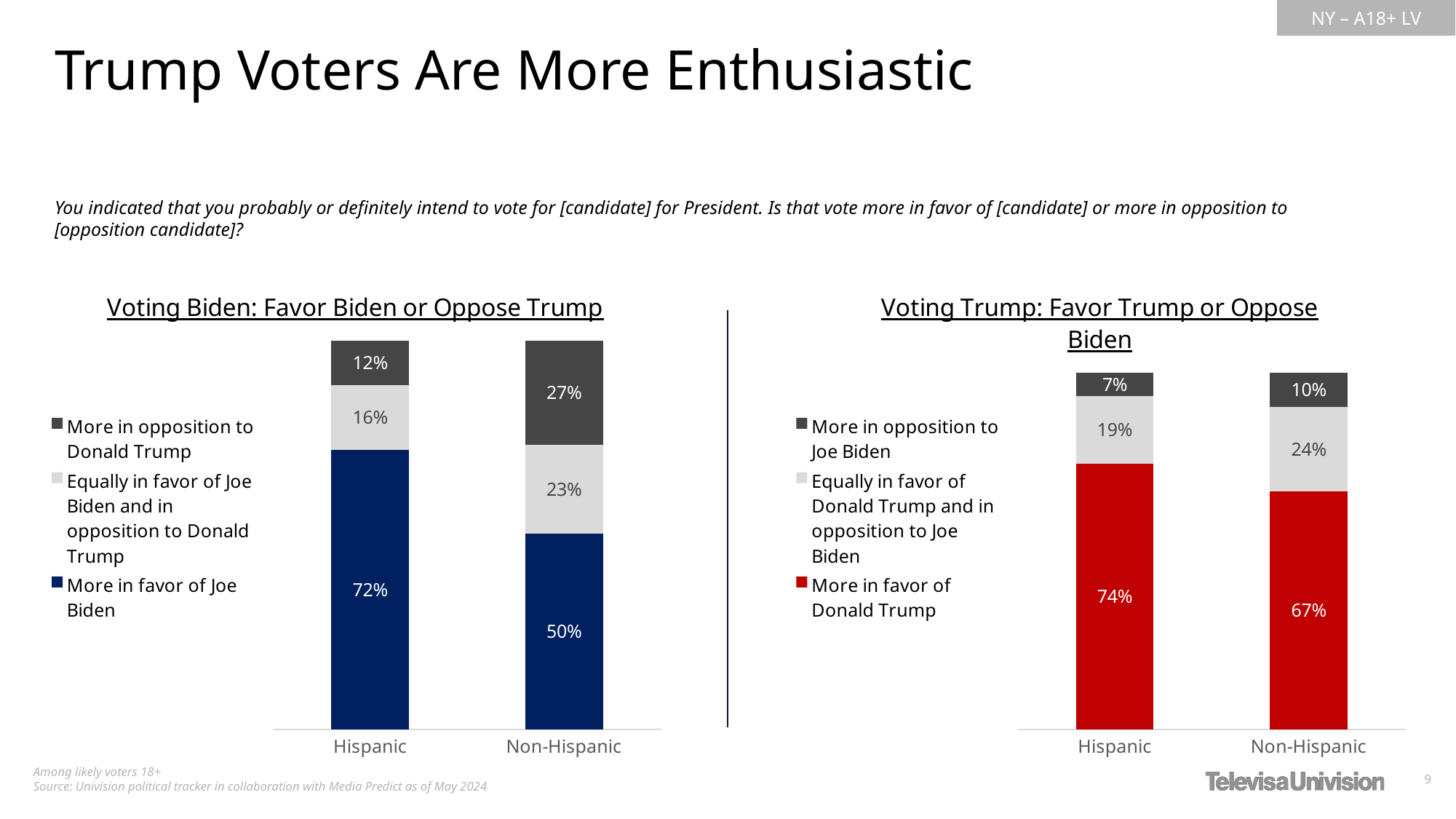
In the 'Voting Trump: Favor Trump or Oppose Biden' chart, what percentage of Hispanic voters are 'Equally in favor of Donald Trump and in opposition to Joe Biden'? 19% How many categories are shown on the x axis of the 'Voting Trump: Favor Trump or Oppose Biden' chart? 2 In the 'Voting Trump: Favor Trump or Oppose Biden' chart, which group has the higher 'More in favor of Donald Trump' value, Hispanic or Non-Hispanic? Hispanic In the 'Voting Biden: Favor Biden or Oppose Trump' chart, which group has the lower 'More in opposition to Donald Trump' value? Hispanic How many series does the legend of the 'Voting Biden: Favor Biden or Oppose Trump' chart list? 3 In the 'Voting Biden: Favor Biden or Oppose Trump' chart, what is the difference between the 'More in favor of Joe Biden' values for Hispanic and Non-Hispanic voters? 22 percentage points In the 'Voting Trump: Favor Trump or Oppose Biden' chart, what percentage of Non-Hispanic voters are 'More in favor of Donald Trump'? 67% In the 'Voting Trump: Favor Trump or Oppose Biden' chart, what is the total of the Non-Hispanic stacked bar? 101% What kind of chart is the 'Voting Biden: Favor Biden or Oppose Trump' chart? Stacked bar chart In the 'Voting Biden: Favor Biden or Oppose Trump' chart, what percentage of Non-Hispanic voters are 'More in opposition to Donald Trump'? 27% In the 'Voting Biden: Favor Biden or Oppose Trump' chart, what percentage of Hispanic voters are 'More in favor of Joe Biden'? 72% In the 'Voting Trump: Favor Trump or Oppose Biden' chart, what colour represents 'More in favor of Donald Trump'? Red